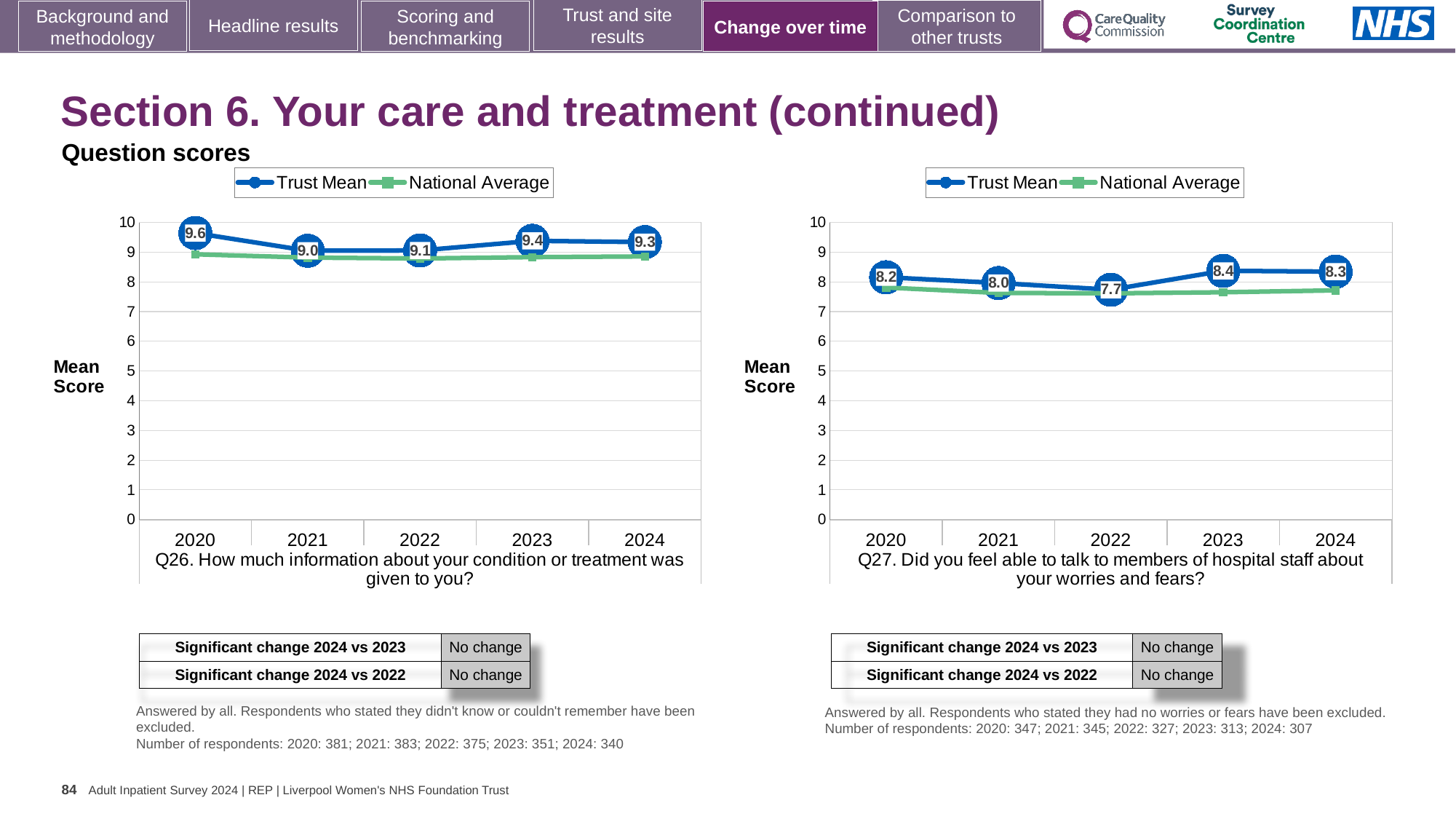
In the Q26 chart (left), which year has the highest Trust Mean score? 2020 In the Q26 chart (left), what is the difference between the Trust Mean scores for 2020 and 2021? 0.6 In the Q27 chart (right), does the Trust Mean score rise or fall from 2022 to 2023? Rise In the Q27 chart (right), is the Trust Mean score higher in 2023 or in 2024? 2023 In the Q26 chart (left), is the National Average for 2020 greater or less than 8? greater In the Q27 chart (right), what is the Trust Mean score for 2022? 7.7 How many series does the legend of the Q27 chart (right) list? 2 In the Q27 chart (right), what is the difference between the Trust Mean scores for 2023 and 2022? 0.7 How many years are plotted on the x axis of the Q26 chart (left)? 5 What type of chart is used for Q26 (left)? Line chart In the Q26 chart (left), what is the Trust Mean score for 2020? 9.6 In the Q27 chart (right), which year has the lowest Trust Mean score? 2022